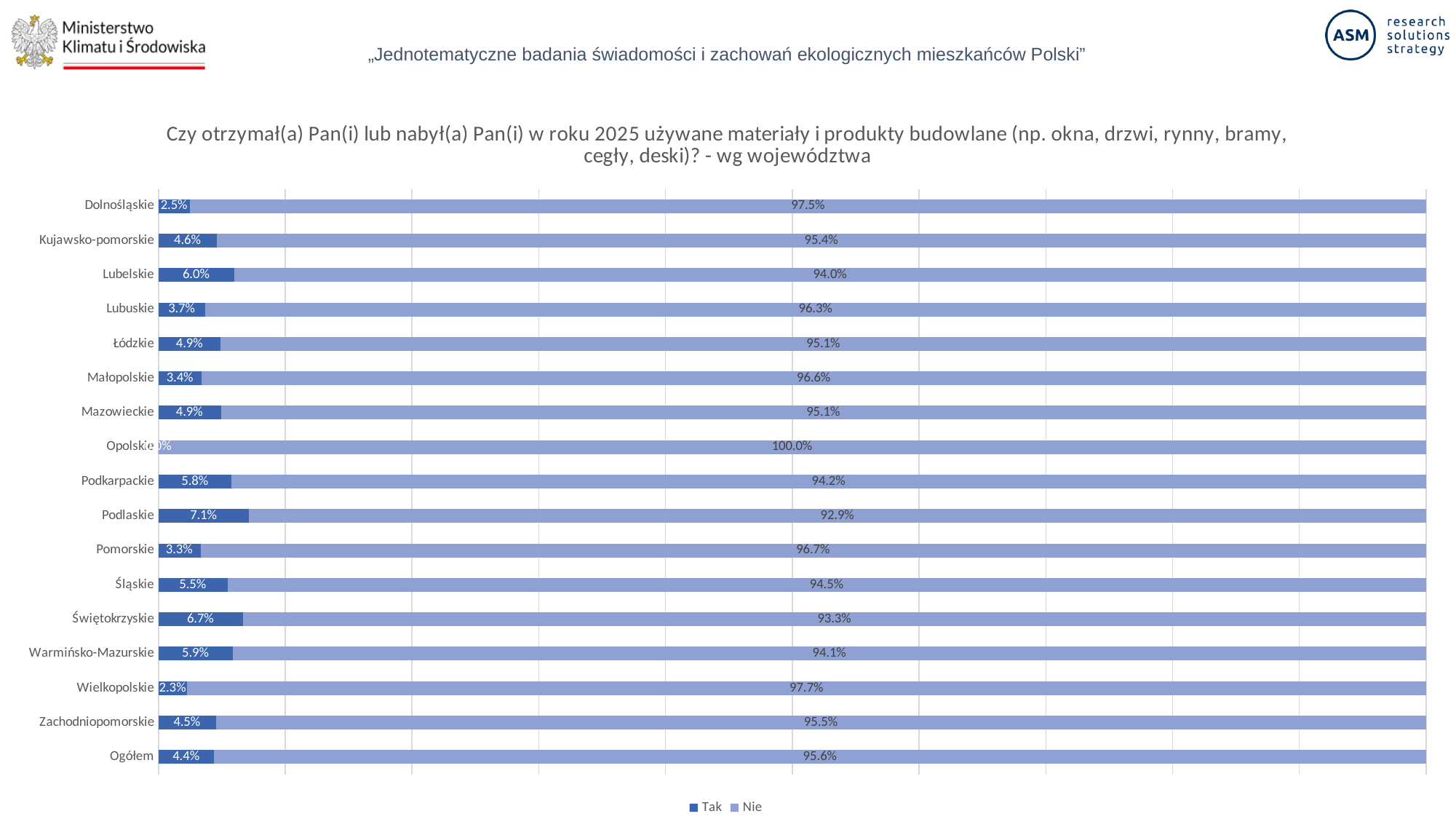
What is the 'Tak' value for Ogółem? 4.4% How many categories are shown on the y axis of the chart? 17 Which category has the highest 'Tak' value? Podlaskie What are the two legend entries of the chart? Tak and Nie What is the 'Tak' value for Podlaskie? 7.1% How many series does the legend list? 2 Which has a larger 'Tak' value, Lubelskie or Śląskie? Lubelskie What is the difference between the 'Tak' values for Podlaskie and Wielkopolskie? 4.8 percentage points What kind of chart is shown on the slide? Stacked bar chart What is the 'Nie' value for Dolnośląskie? 97.5% What is the 'Nie' value for Opolskie? 100.0% Which category has the lowest 'Nie' value? Podlaskie